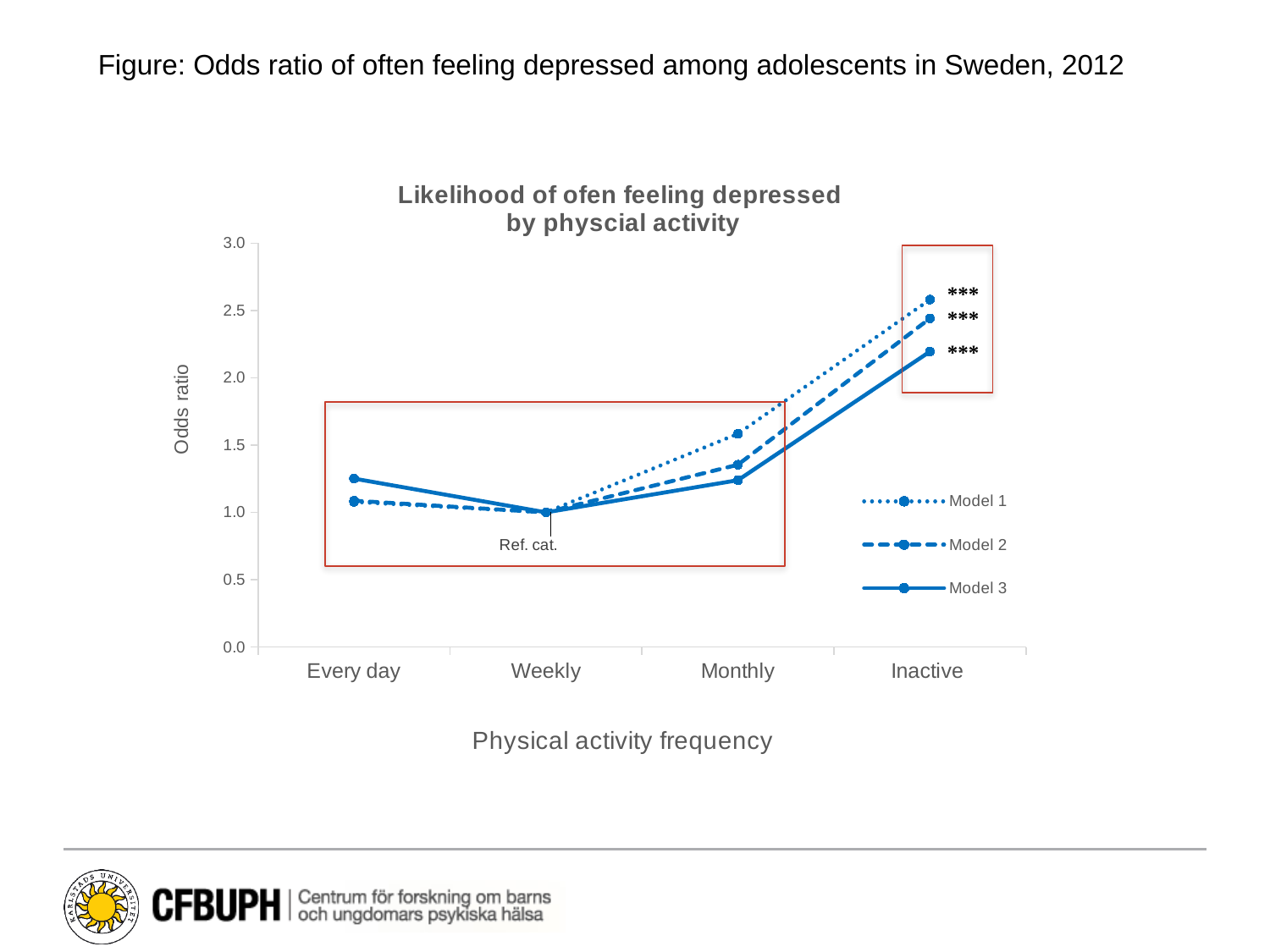
Is the odds ratio for Model 3 at Monthly greater or less than 1.5? less Is the odds ratio for Model 1 at Inactive greater or less than 2.0? greater How many series does the legend list? 3 What kind of chart is shown on the slide? Line chart For Model 1, which physical activity category has the lowest odds ratio? Weekly What is the label on the y axis of the chart? Odds ratio At the Inactive category, which has the higher odds ratio, Model 1 or Model 3? Model 1 What is the odds ratio for Model 3 at the Weekly category (the reference category)? 1.0 For Model 1, which physical activity category has the highest odds ratio? Inactive Do the odds ratios rise or fall from Weekly to Inactive along the x axis? rise How many physical activity frequency categories are shown on the x axis? 4 Is the odds ratio for Model 3 at Inactive greater or less than 2.5? less